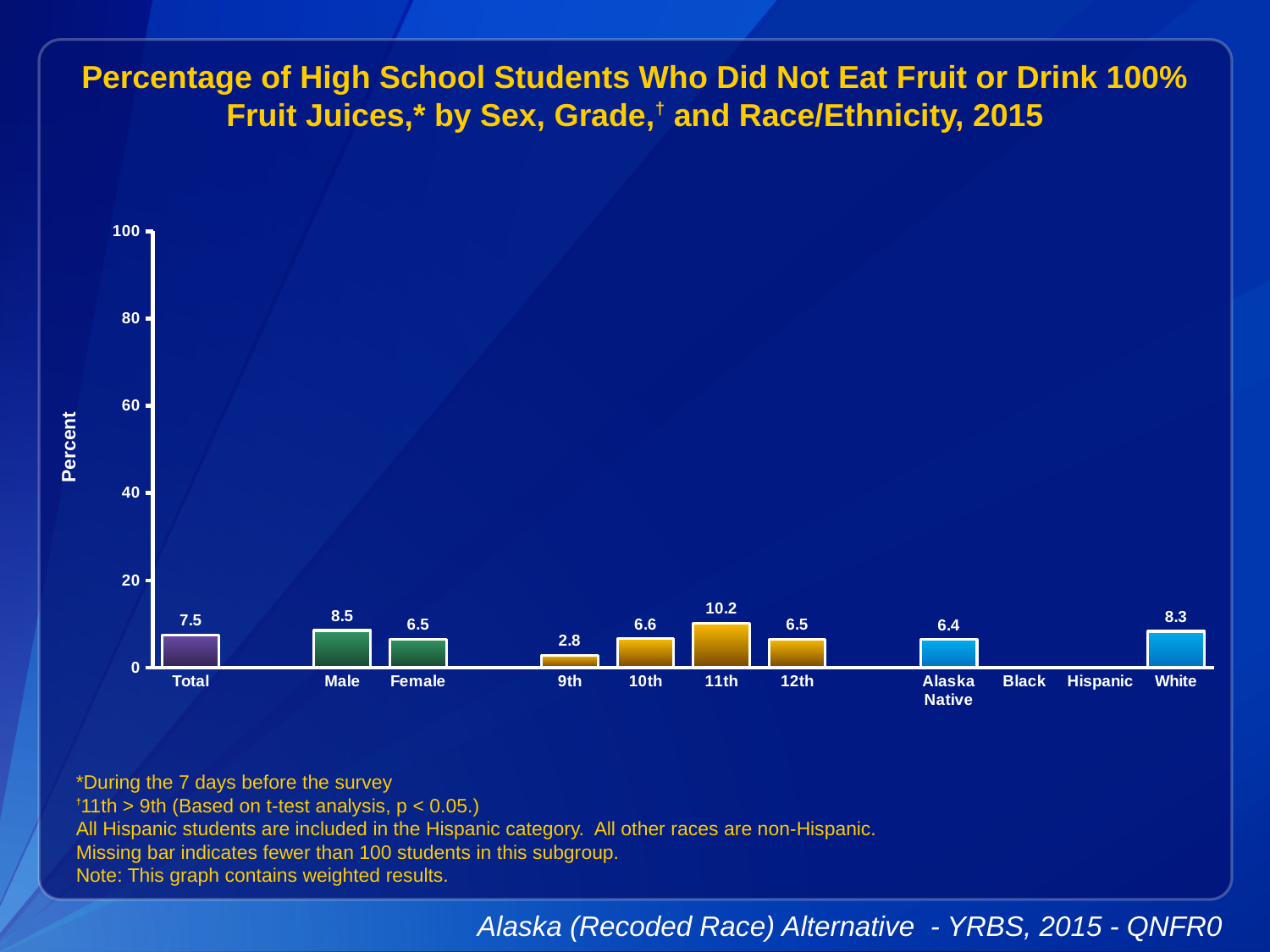
Which category with a bar has the lowest value? 9th How many categories have a bar plotted? 9 Which category has the highest value? 11th What is the label on the y axis? Percent Is the value for White greater or less than 20? less What is the value for 9th grade? 2.8 What is the value for Alaska Native? 6.4 What is the value for Male? 8.5 What is the difference between the values for Male and Female? 2.0 Which is larger, the value for 11th grade or the value for 12th grade? 11th What kind of chart is shown? bar chart What is the value for Total? 7.5